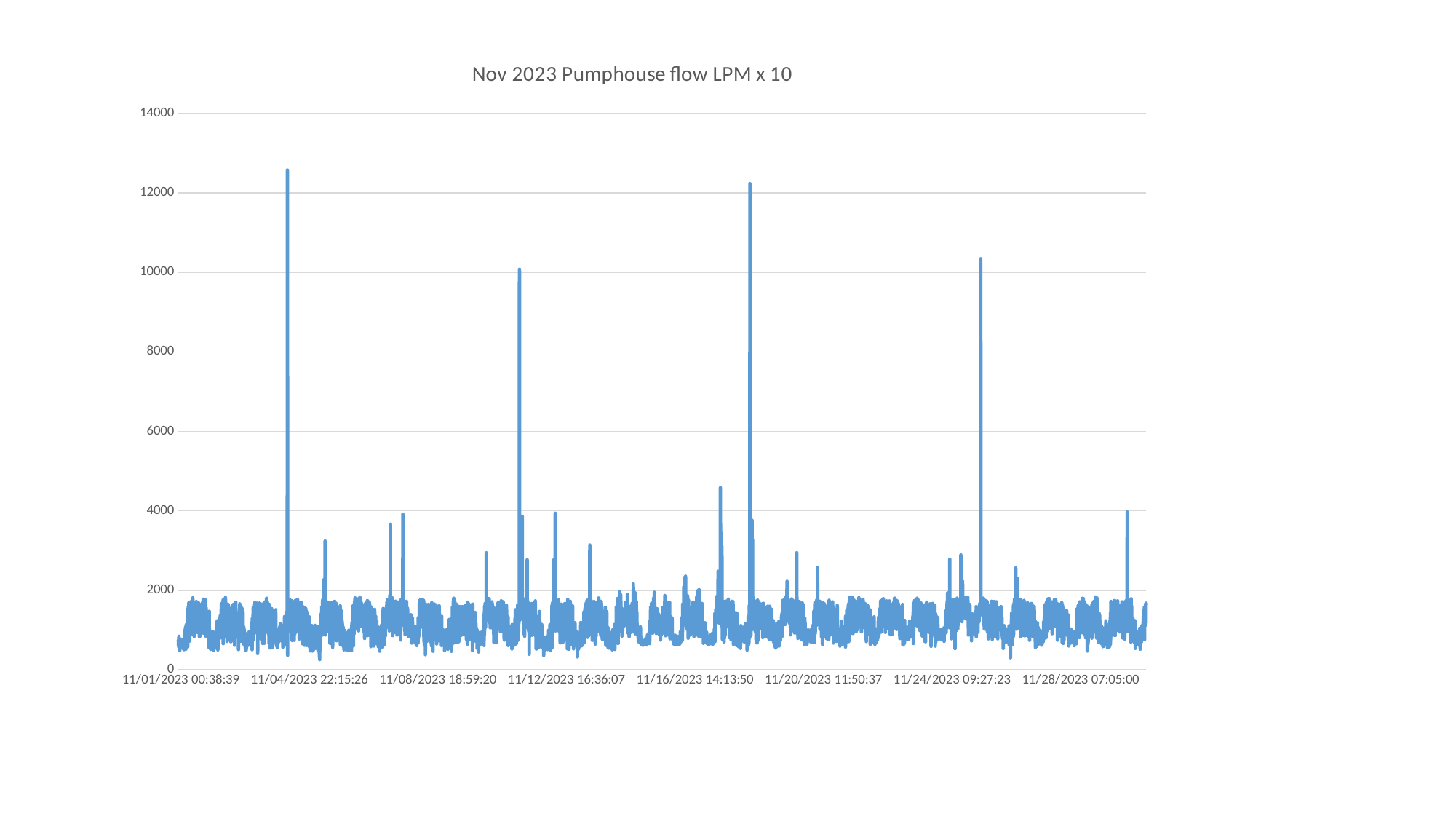
What is the last date label on the horizontal axis? 11/28/2023 07:05:00 How many lines are plotted on the chart? 1 What is the first date label on the horizontal axis? 11/01/2023 00:38:39 Is the value at the start of the series, near 11/01/2023 00:38:39, greater or less than 4000? less Is the tallest spike in the series greater or less than 14000? less Is the tallest spike in the series greater or less than 12000? greater How many date labels are shown along the horizontal axis? 8 Does the tallest spike occur before or after the 11/16/2023 14:13:50 label? before What is the title of the chart? Nov 2023 Pumphouse flow LPM x 10 What kind of chart is shown on the slide? Line chart What is the highest value shown on the vertical axis? 14000